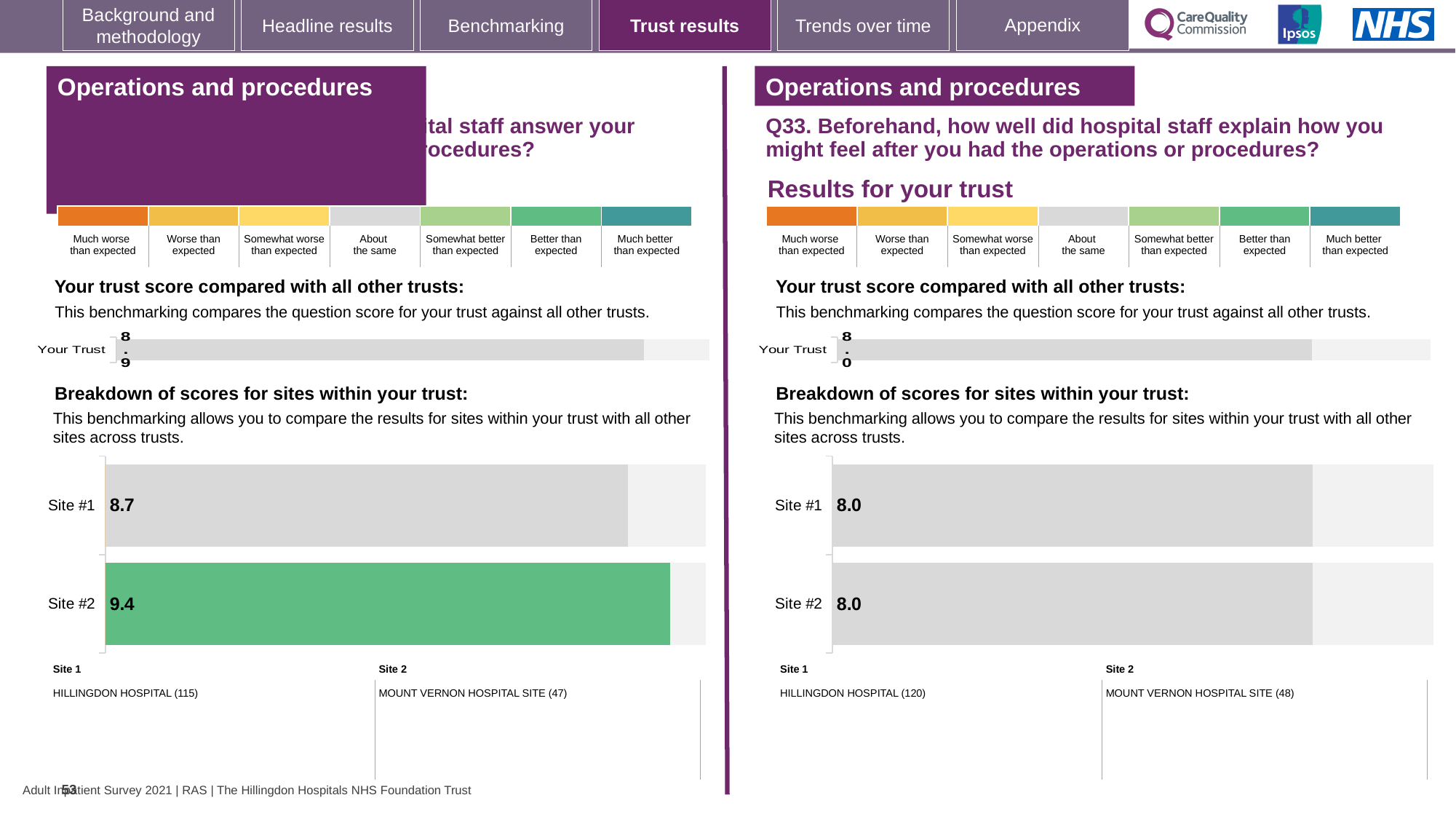
Which site has the higher Site #1 score: the left panel or the right panel (Q33)? Left panel What type of chart is used for the site breakdown on the left panel? Bar chart How many sites are shown in the site breakdown chart on the right panel (Q33)? 2 On the left panel's site breakdown chart, what is the score for Site #2? 9.4 On the left panel's site breakdown chart, which site has the higher score? Site #2 On the left panel's site breakdown chart, what is the difference between the Site #2 and Site #1 scores? 0.7 On the right panel (Q33) site breakdown chart, what is the score for Site #2? 8.0 On the right panel (Q33) site breakdown chart, what is the score for Site #1? 8.0 On the left panel's site breakdown chart, what colour is the bar for Site #2? Green On the right panel (Q33), what is the 'Your Trust' score shown in the trust comparison chart? 8.0 On the left panel, what is the 'Your Trust' score shown in the trust comparison chart? 8.9 On the left panel's site breakdown chart, what is the score for Site #1? 8.7